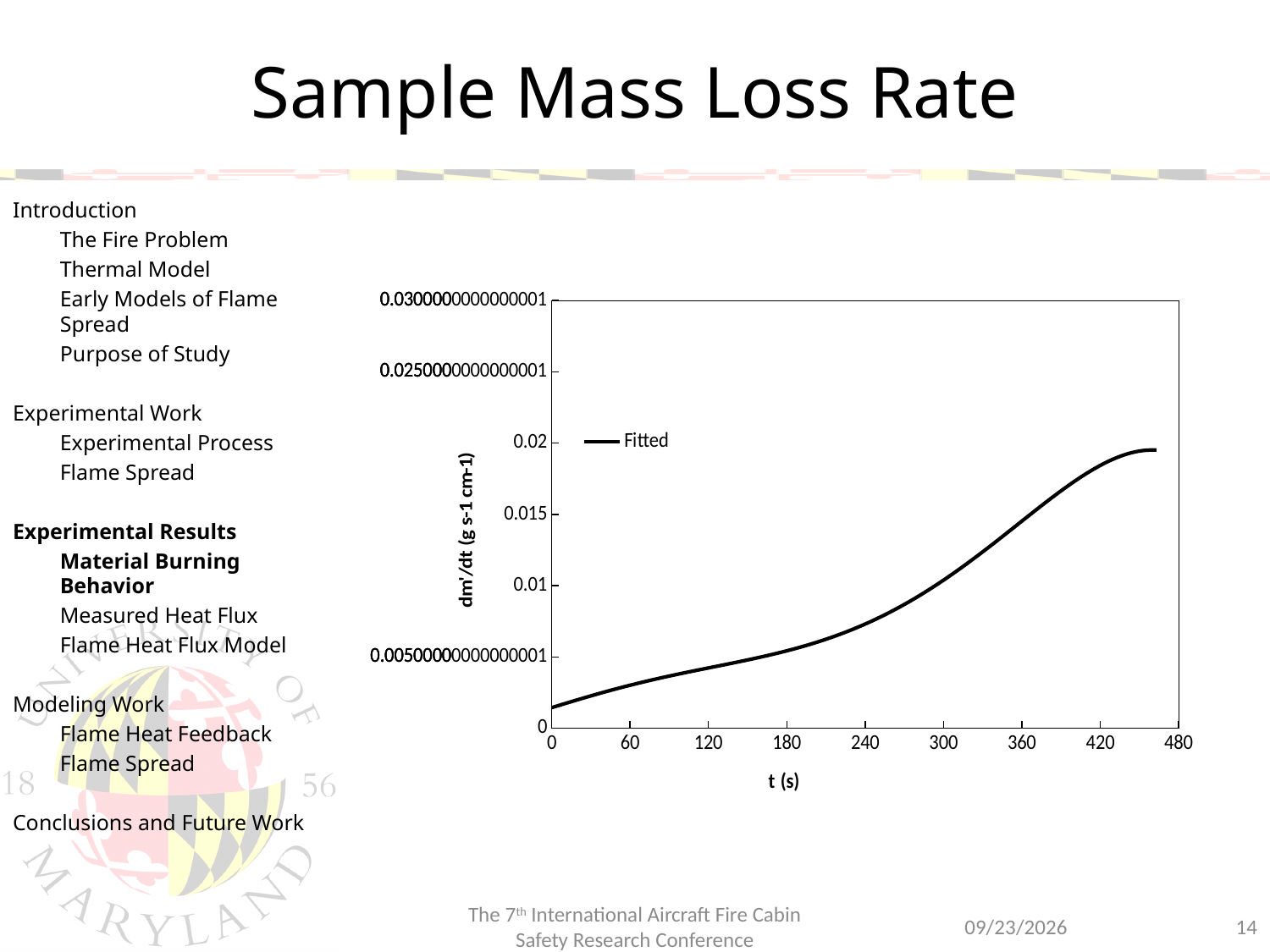
What is the label of the x axis of the chart? t (s) Does the Fitted curve rise or fall as t increases from 0 to 420 s? rise Is the value of the Fitted curve at t = 420 s greater or less than 0.015? greater How many series does the chart's legend list? 1 What kind of chart is shown on the slide? line chart Is the value of the Fitted curve at t = 240 s greater or less than 0.005? greater Is the value of the Fitted curve at t = 240 s greater or less than 0.01? less What is the name of the series shown in the chart's legend? Fitted Which is larger, the value of the Fitted curve at t = 60 s or at t = 300 s? t = 300 s